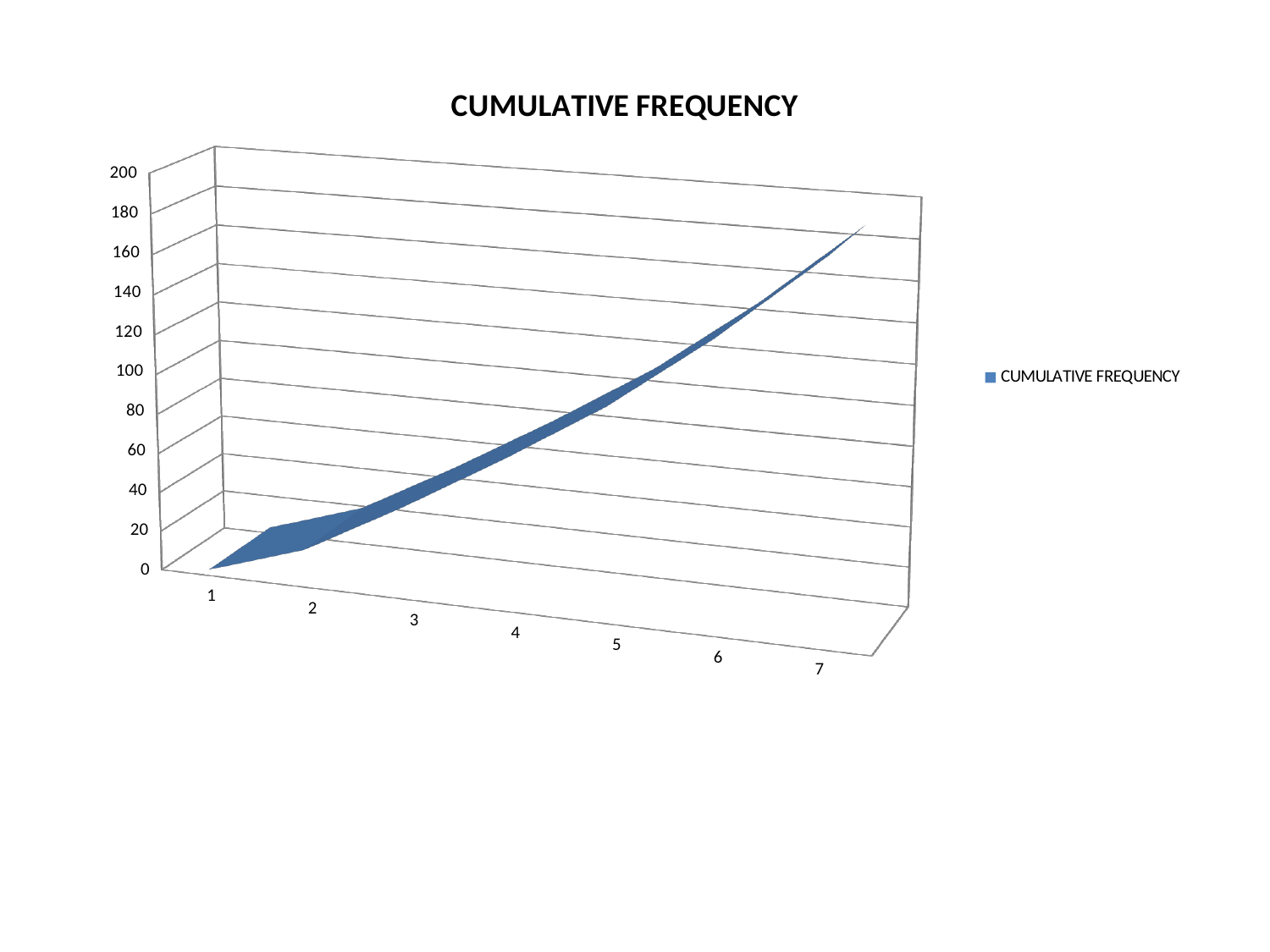
Which category has the lowest cumulative frequency? 1 Which is larger, the value for category 7 or the value for category 1? category 7 How many series does the legend list? 1 What kind of chart is shown on the slide? 3D line chart Is the value for category 1 greater or less than 20? less Is the value for category 2 greater or less than 100? less Which category has the highest cumulative frequency? 7 Is the value for category 7 greater or less than 100? greater What is the title of the chart? CUMULATIVE FREQUENCY What is the name of the series shown in the legend? CUMULATIVE FREQUENCY Do the values rise or fall as the x axis goes from 1 to 7? rise How many categories are shown along the x axis? 7